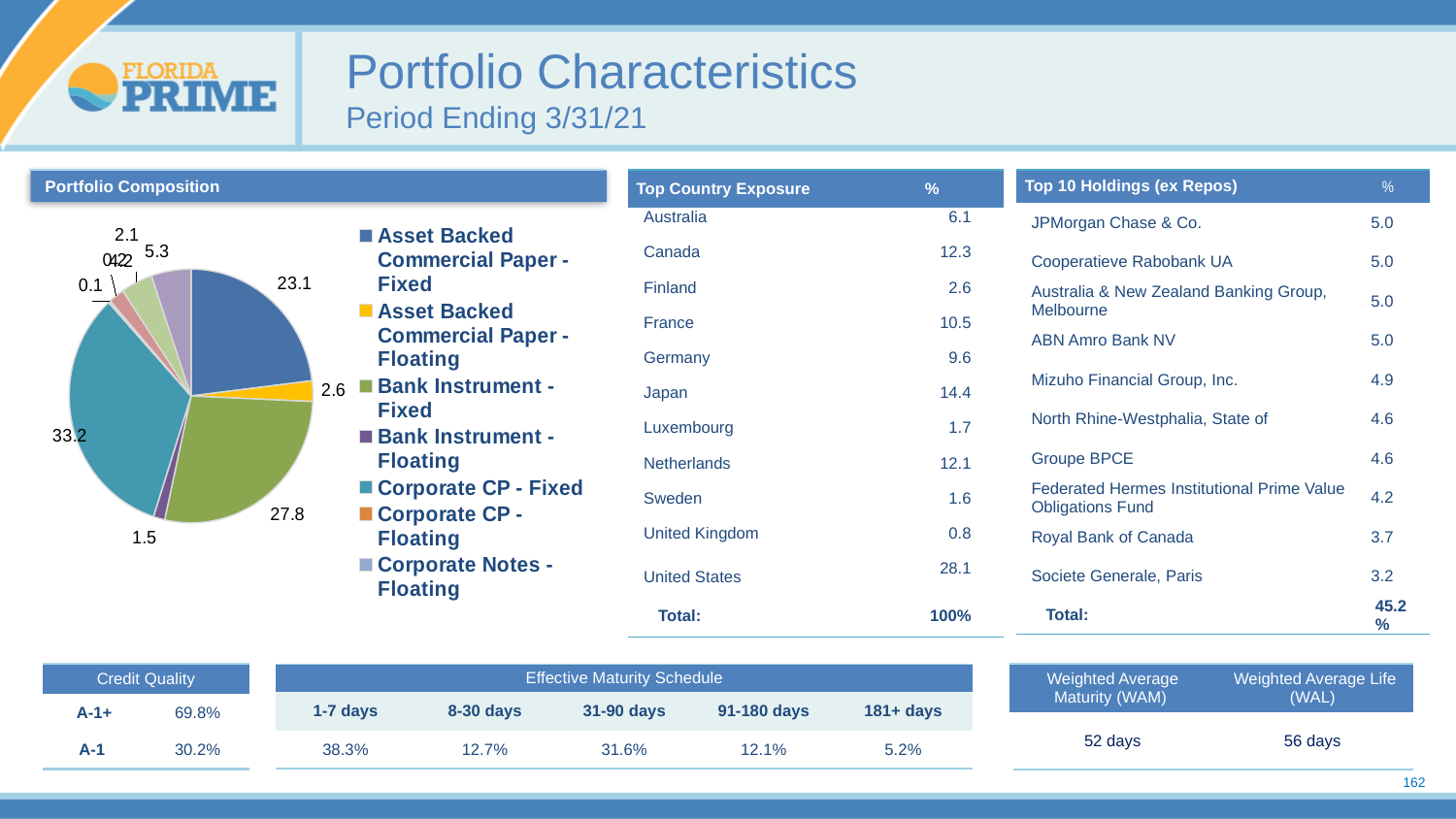
In the Portfolio Composition pie chart, which is larger: Asset Backed Commercial Paper - Floating or Bank Instrument - Floating? Asset Backed Commercial Paper - Floating In the Portfolio Composition pie chart, what is the value of the largest slice? 33.2 In the Portfolio Composition pie chart, which is larger: Bank Instrument - Fixed or Asset Backed Commercial Paper - Fixed? Bank Instrument - Fixed In the Portfolio Composition pie chart, what is the value for Bank Instrument - Floating? 1.5 In the Portfolio Composition pie chart, which category has the largest slice? Corporate CP - Fixed In the Portfolio Composition pie chart, what is the value for Asset Backed Commercial Paper - Floating? 2.6 In the Portfolio Composition pie chart, what is the value for Bank Instrument - Fixed? 27.8 How many entries does the legend of the Portfolio Composition pie chart list? 7 What is the title of the pie chart on the slide? Portfolio Composition What kind of chart is shown under Portfolio Composition? pie chart In the Portfolio Composition pie chart, what is the value for Asset Backed Commercial Paper - Fixed? 23.1 In the Portfolio Composition pie chart, what is the difference between the Corporate CP - Fixed slice and the Bank Instrument - Fixed slice? 5.4